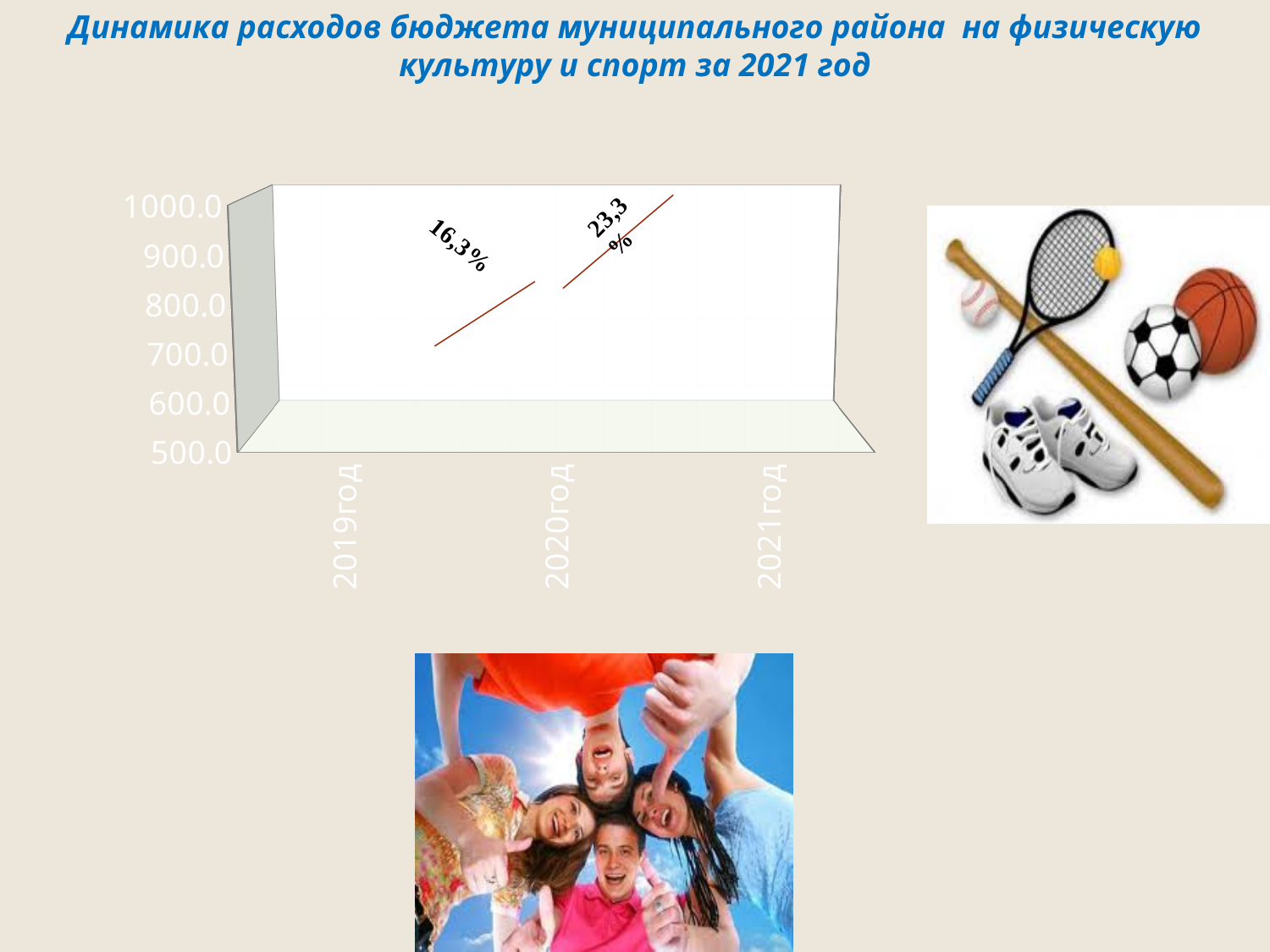
What percentage label is printed on the line segment between 2019год and 2020год? 16,3% What is the title of the slide containing the chart? Динамика расходов бюджета муниципального района на физическую культуру и спорт за 2021 год What is the lowest tick value shown on the vertical axis of the chart? 500.0 What percentage label is printed on the line segment between 2020год and 2021год? 23,3% How many years are shown on the x axis of the chart? 3